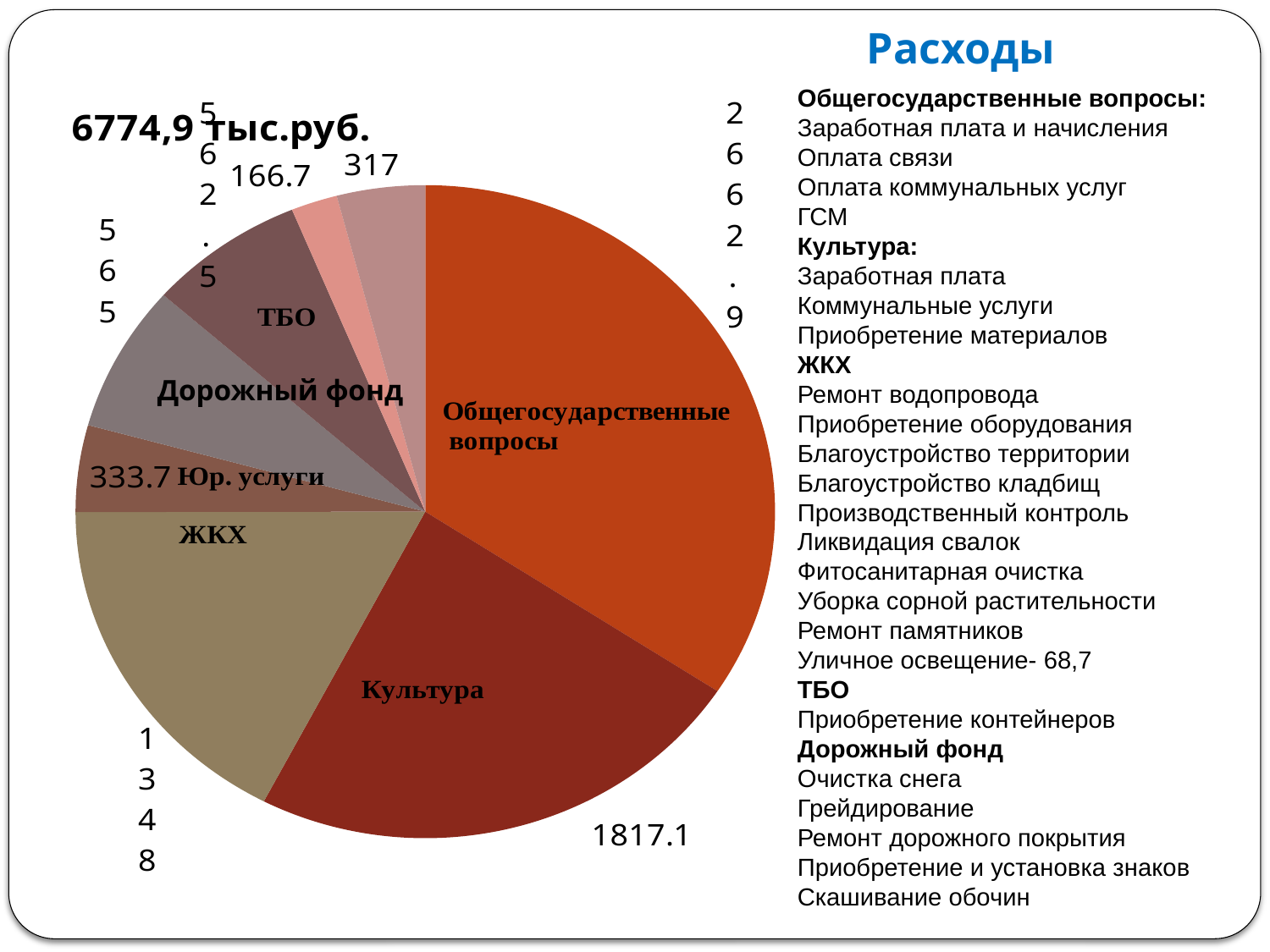
What kind of chart is shown on the slide? pie chart What is the value of the Общегосударственные вопросы slice? 2662.9 What is the title of the chart on the slide? 6774,9 тыс.руб. Which category has the largest slice of the pie? Общегосударственные вопросы What is the value of the smallest slice of the pie? 166.7 What total amount is printed above the pie chart? 6774,9 тыс.руб. What is the difference between the Культура and ЖКХ values? 469.1 How many slices does the pie chart have? 8 Which is larger, Культура or ЖКХ? Культура What is the value of the Культура slice? 1817.1 What is the value of the ЖКХ slice? 1348 What is the value of the Юр. услуги slice? 333.7